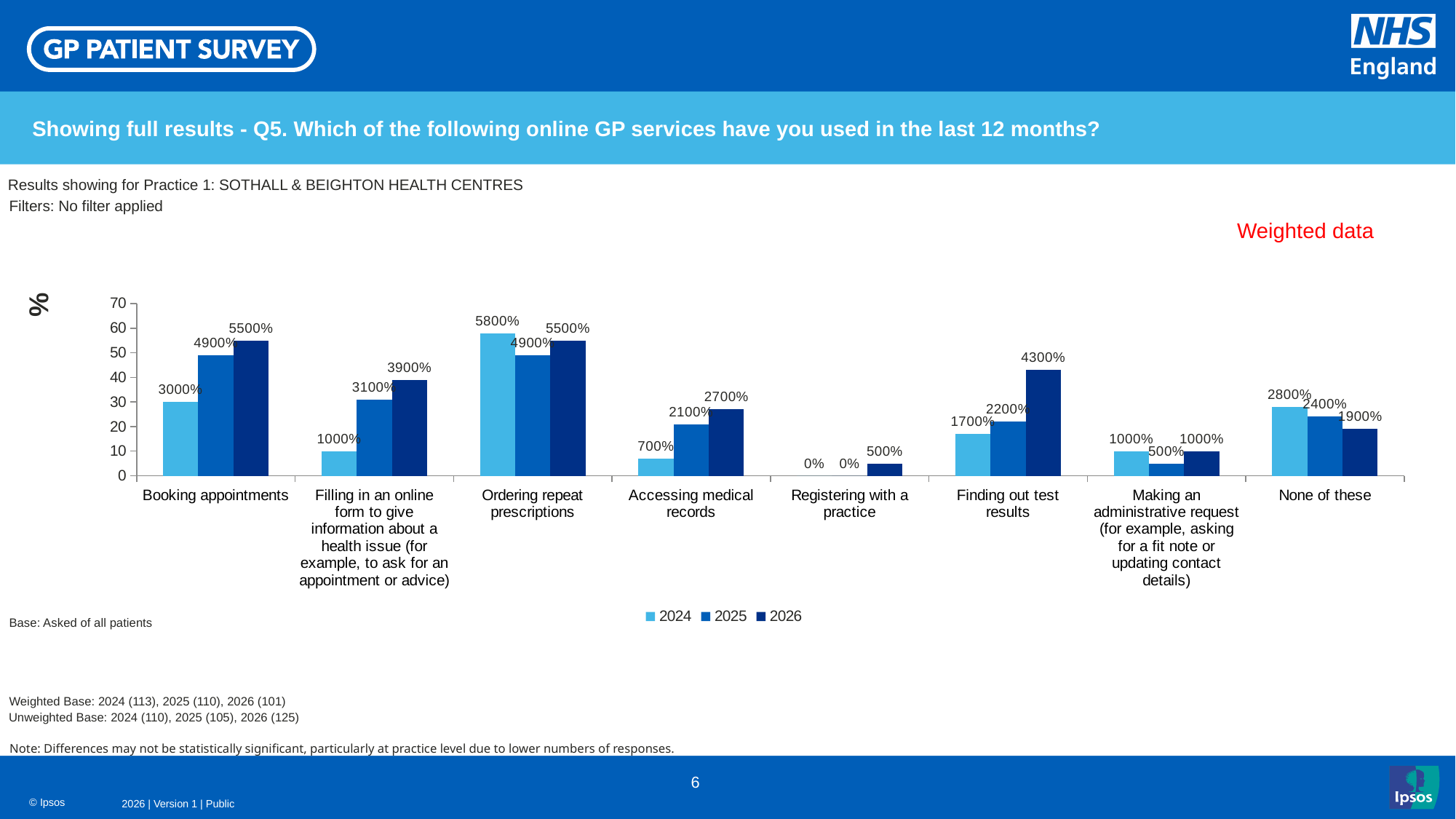
What is the 2024 value for Ordering repeat prescriptions? 5800% What kind of chart is shown on the slide? Bar chart What is the 2025 value for Finding out test results? 2200% Which category has the highest 2024 value? Ordering repeat prescriptions What is the 2026 value for Registering with a practice? 500% Which category has the lowest 2026 value? Registering with a practice What is the difference between the 2026 and 2024 values for Booking appointments? 2500% How many series does the legend list? 3 Do the values for None of these rise or fall from 2024 to 2026? Fall How many categories are shown on the x axis? 8 Which is larger for Finding out test results: the 2025 value or the 2026 value? 2026 What is the 2026 value for Booking appointments? 5500%